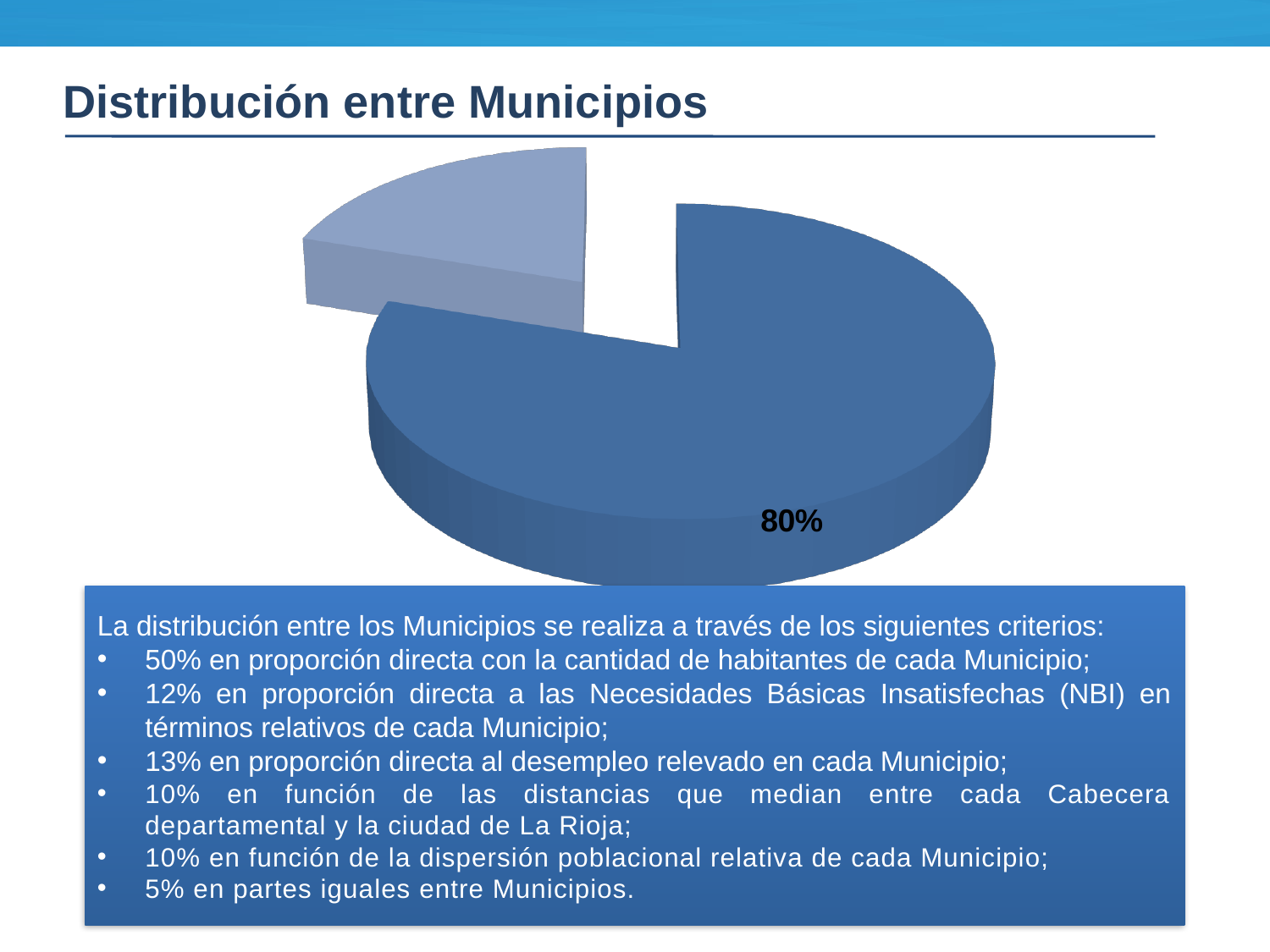
Which slice of the pie chart is larger, the dark blue one or the light blue one? dark blue What colour is the slice labelled 80% in the pie chart? dark blue How many slices does the pie chart have? 2 What percentage is printed on the large dark blue slice of the pie chart? 80% Is the dark blue slice of the pie chart greater or less than 50% of the pie? greater What is the title of the slide containing the pie chart? Distribución entre Municipios Is the light blue slice of the pie chart greater or less than 50% of the pie? less What kind of chart is shown on the slide? pie chart What is the value of the largest slice in the pie chart? 80%